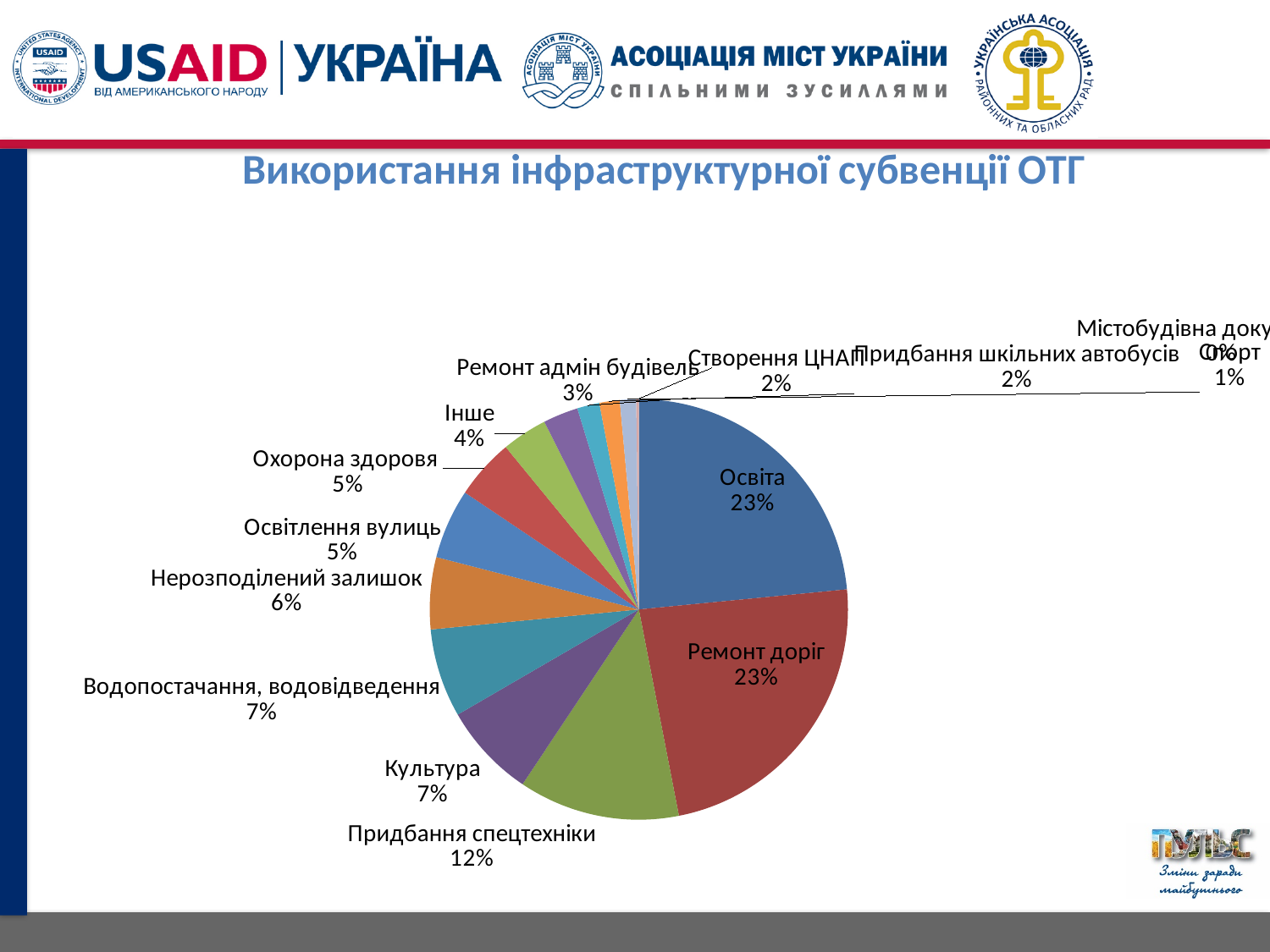
What is the difference in percentage points between Освітлення вулиць and Спорт? 4 Which is larger, Культура or Інше? Культура What share of the pie does Освіта account for? 23% What percentage is shown for Придбання спецтехніки? 12% Which is larger, Придбання спецтехніки or Охорона здоровя? Придбання спецтехніки What percentage is shown for Ремонт адмін будівель? 3% What is the value for Водопостачання, водовідведення? 7% What kind of chart is shown on the slide? Pie chart What share is labelled for Нерозподілений залишок? 6% What is the title of the chart? Використання інфраструктурної субвенції ОТГ What is the value for Створення ЦНАП? 2% What is the difference in percentage points between Ремонт доріг and Придбання спецтехніки? 11